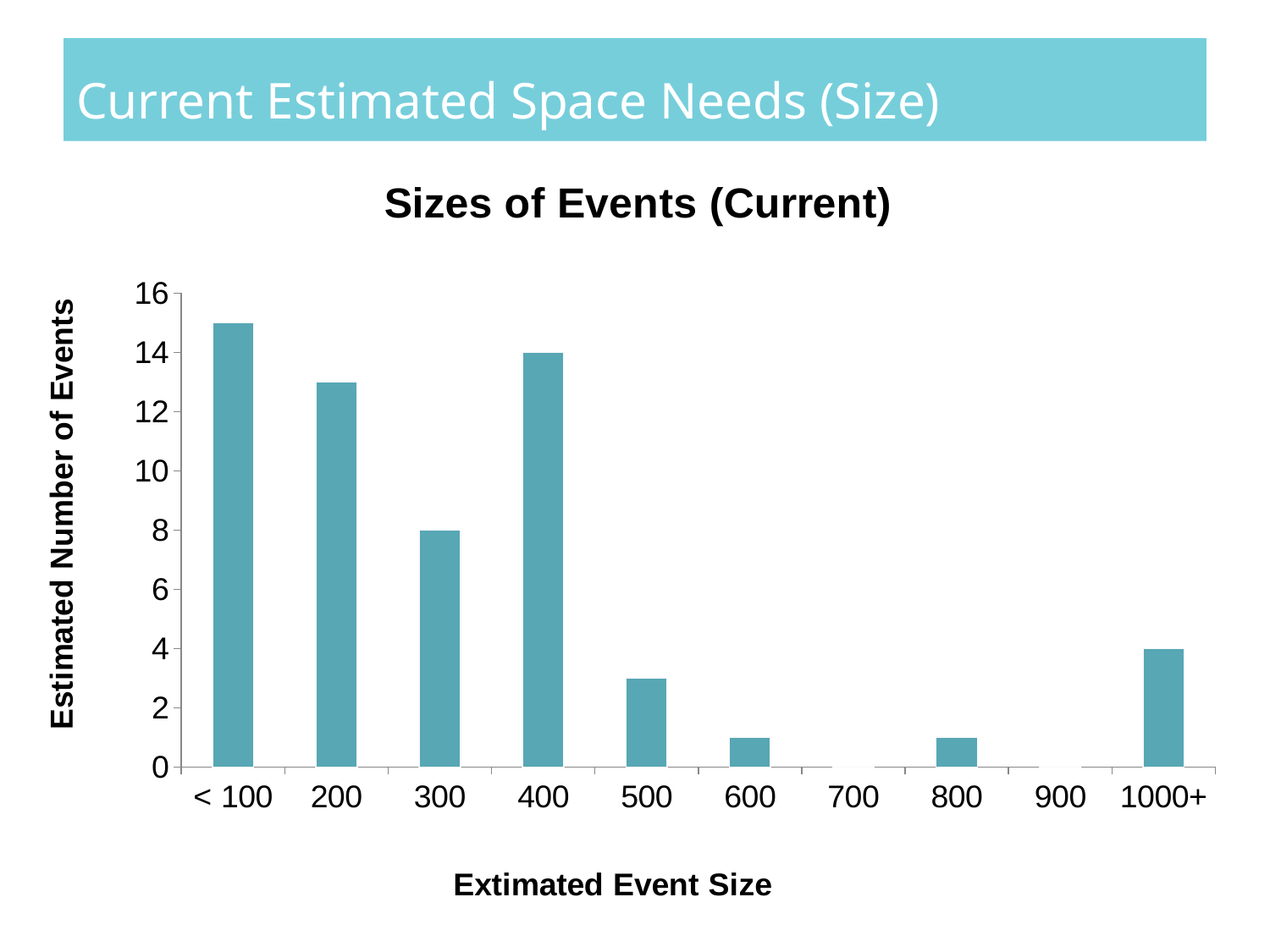
Is the value for event size 200 greater or less than 12? greater What kind of chart is shown on the slide? bar chart Which event size category has the highest estimated number of events? < 100 Which has more estimated events, event size 400 or event size 300? 400 Is the value for event size 500 greater or less than 4? less Is the value for event size < 100 greater or less than 14? greater What is the title of the chart? Sizes of Events (Current) What is the estimated number of events for event size 400? 14 What is the difference between the estimated number of events for size 400 and size 300? 6 What is the estimated number of events for event size 1000+? 4 How many event size categories are shown on the x axis? 10 What is the estimated number of events for event size 300? 8